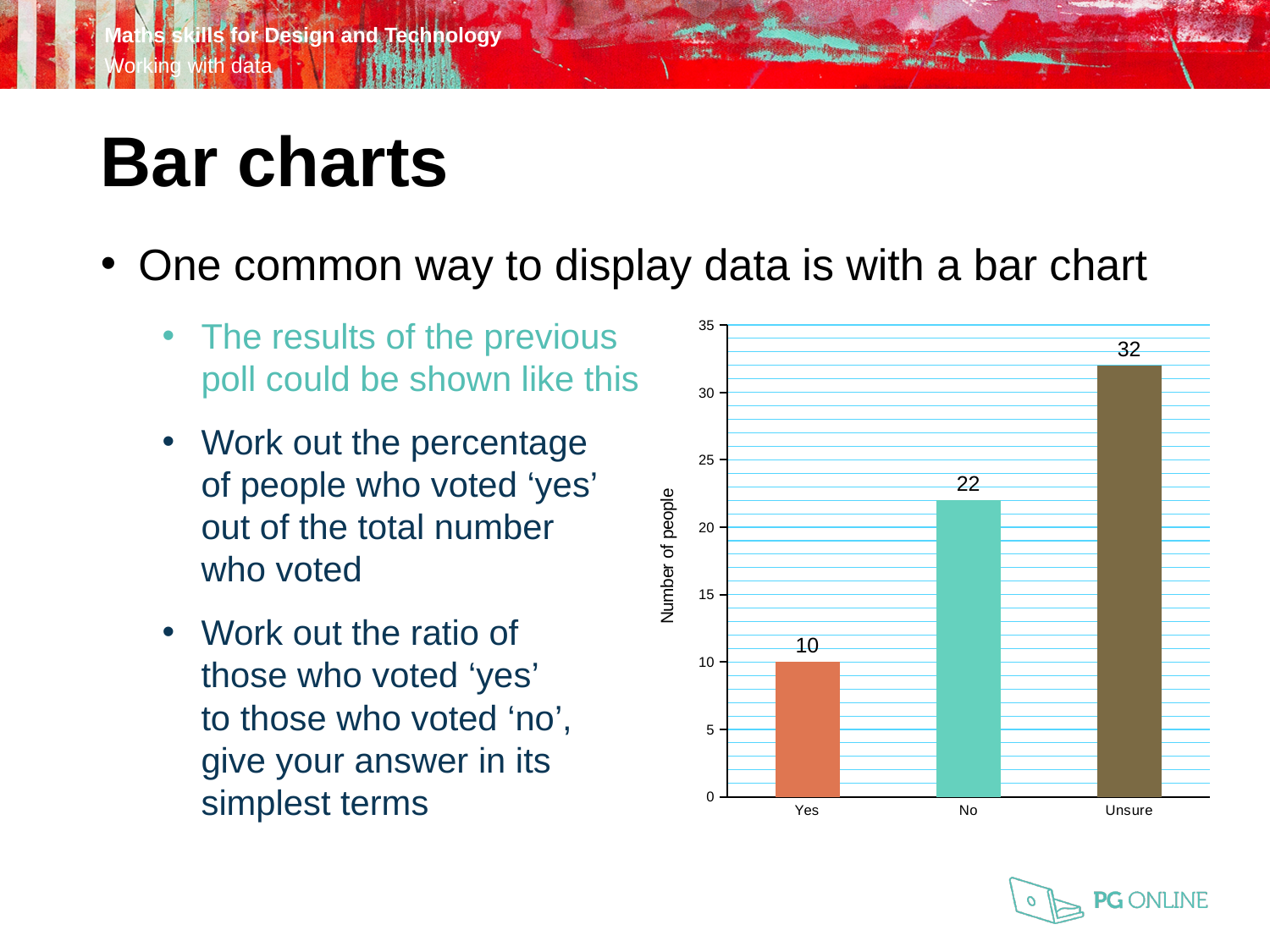
What kind of chart is shown on the slide? bar chart Is the value for 'Unsure' greater or less than 30? greater What is the difference between the number of people who voted 'No' and those who voted 'Yes'? 12 Which category has the highest number of people? Unsure How many categories are shown on the x axis of the chart? 3 What is the difference between the 'Unsure' and 'No' values? 10 Which is larger, the value for 'No' or the value for 'Yes'? No Which category has the lowest number of people? Yes What is the label of the vertical axis of the chart? Number of people What is the number of people who were 'Unsure'? 32 What is the number of people who voted 'No'? 22 What is the number of people who voted 'Yes'? 10